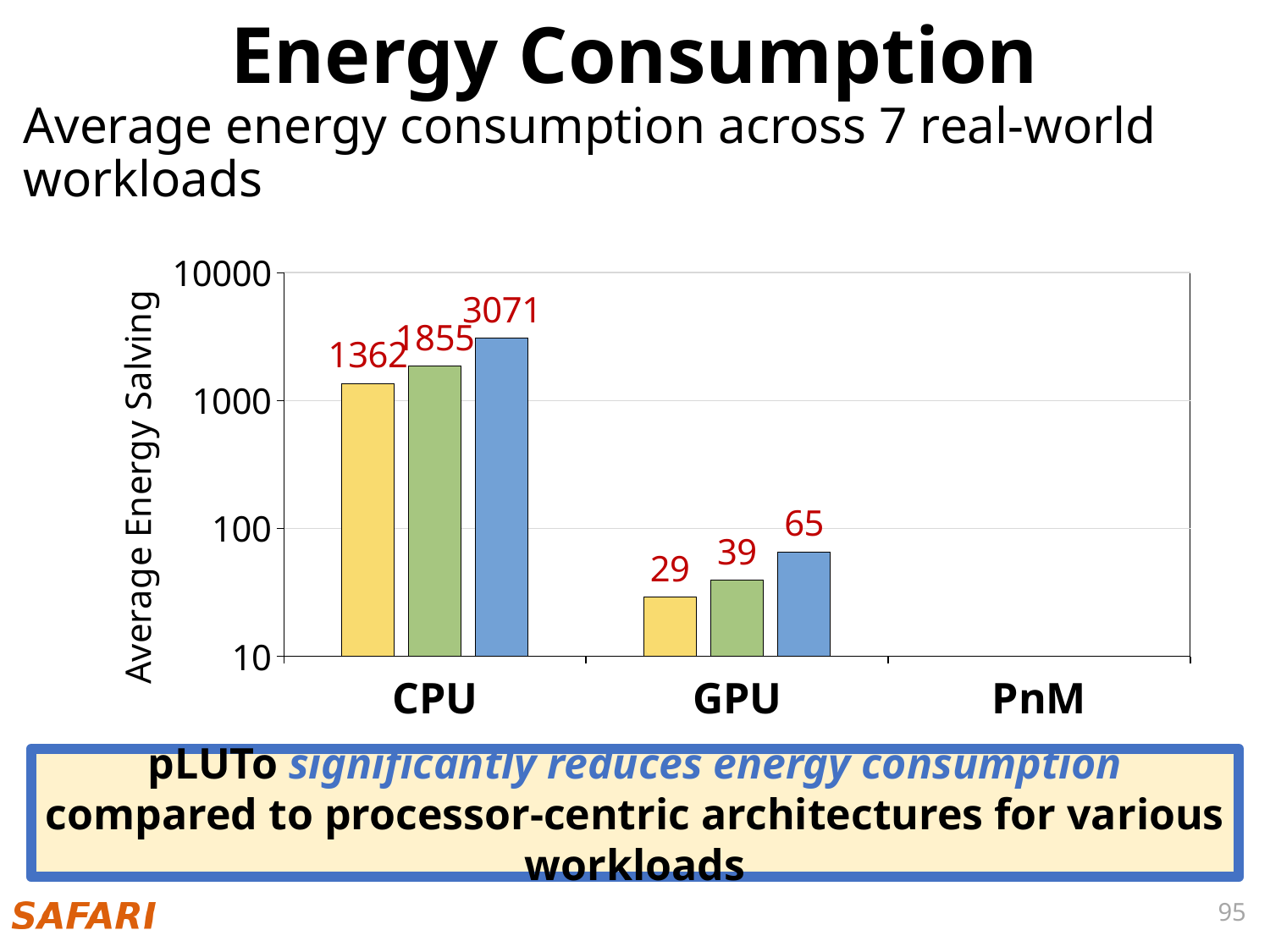
Which is larger, the yellow bar for CPU or the blue bar for GPU? the yellow bar for CPU (1362) What is the value of the green (second) bar for CPU? 1855 What is the difference between the blue bar for GPU and the green bar for GPU? 26 What is the label of the y axis? Average Energy Salving Which of the three CPU bars has the highest value? the blue (third) bar, 3071 What is the value of the yellow (first) bar for GPU? 29 What is the difference between the blue bar for CPU and the yellow bar for CPU? 1709 How many categories are labelled on the x axis? 3 What is the value of the blue (third) bar for CPU? 3071 What kind of chart is shown on the slide? bar chart What is the value of the green (second) bar for GPU? 39 Which of the three GPU bars has the lowest value? the yellow (first) bar, 29